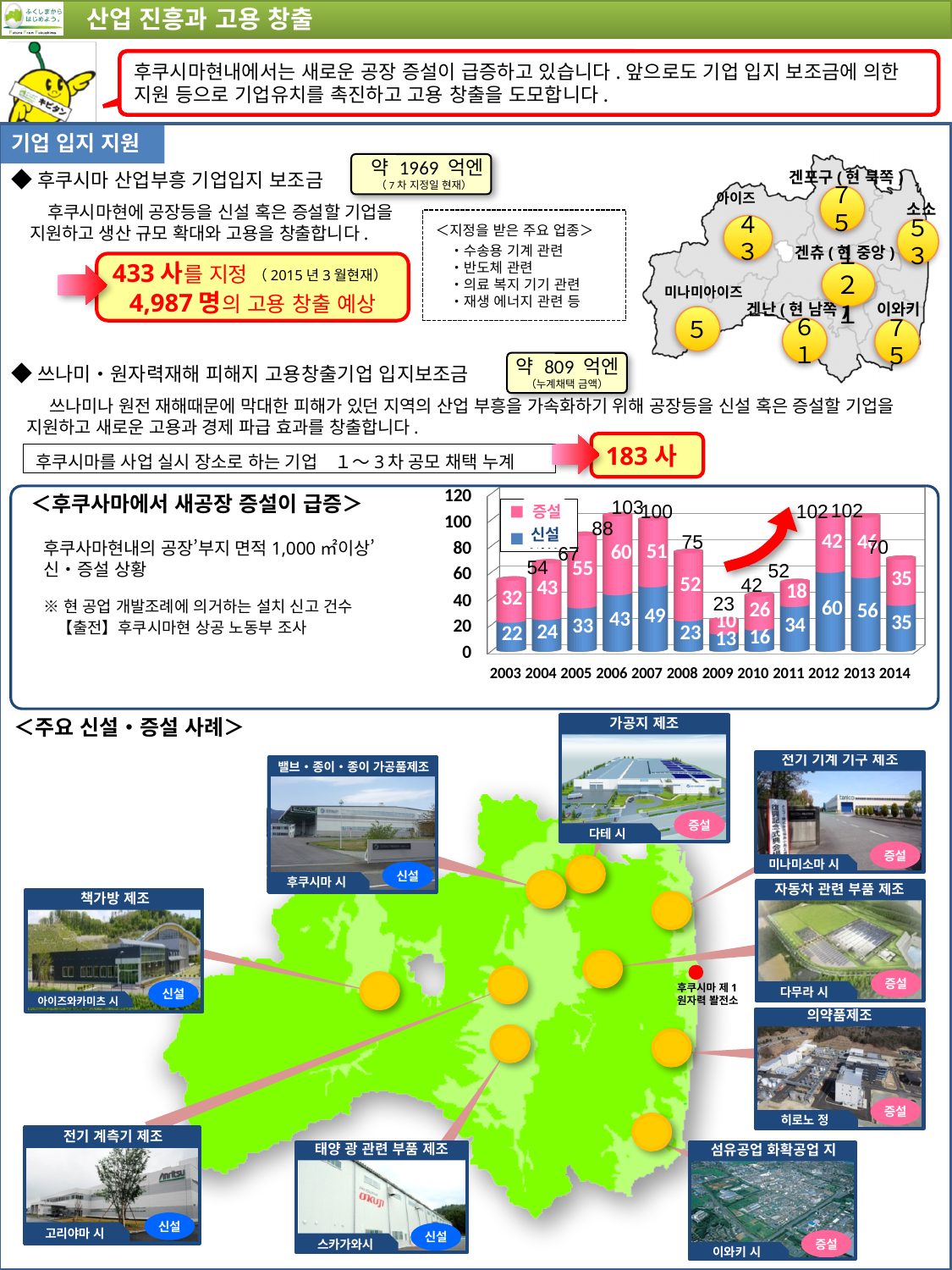
Which year has the highest total in the bar chart? 2006 How many series does the legend of the bar chart list? 2 What is the difference between the 증설 value and the 신설 value in 2008? 29 How many years are shown on the x axis of the bar chart? 12 What is the 증설 value for 2006 in the bar chart? 60 What type of chart is shown in the '후쿠사마에서 새공장 증설이 급증' section? stacked bar chart Which year has the lowest total in the bar chart? 2009 In 2011, which is larger, 신설 or 증설? 신설 What is the total of the stacked bar for 2009? 23 Do the totals in the bar chart rise or fall from 2003 to 2006? rise What is the 신설 value for 2012 in the bar chart? 60 Which series in the bar chart is shown in pink? 증설